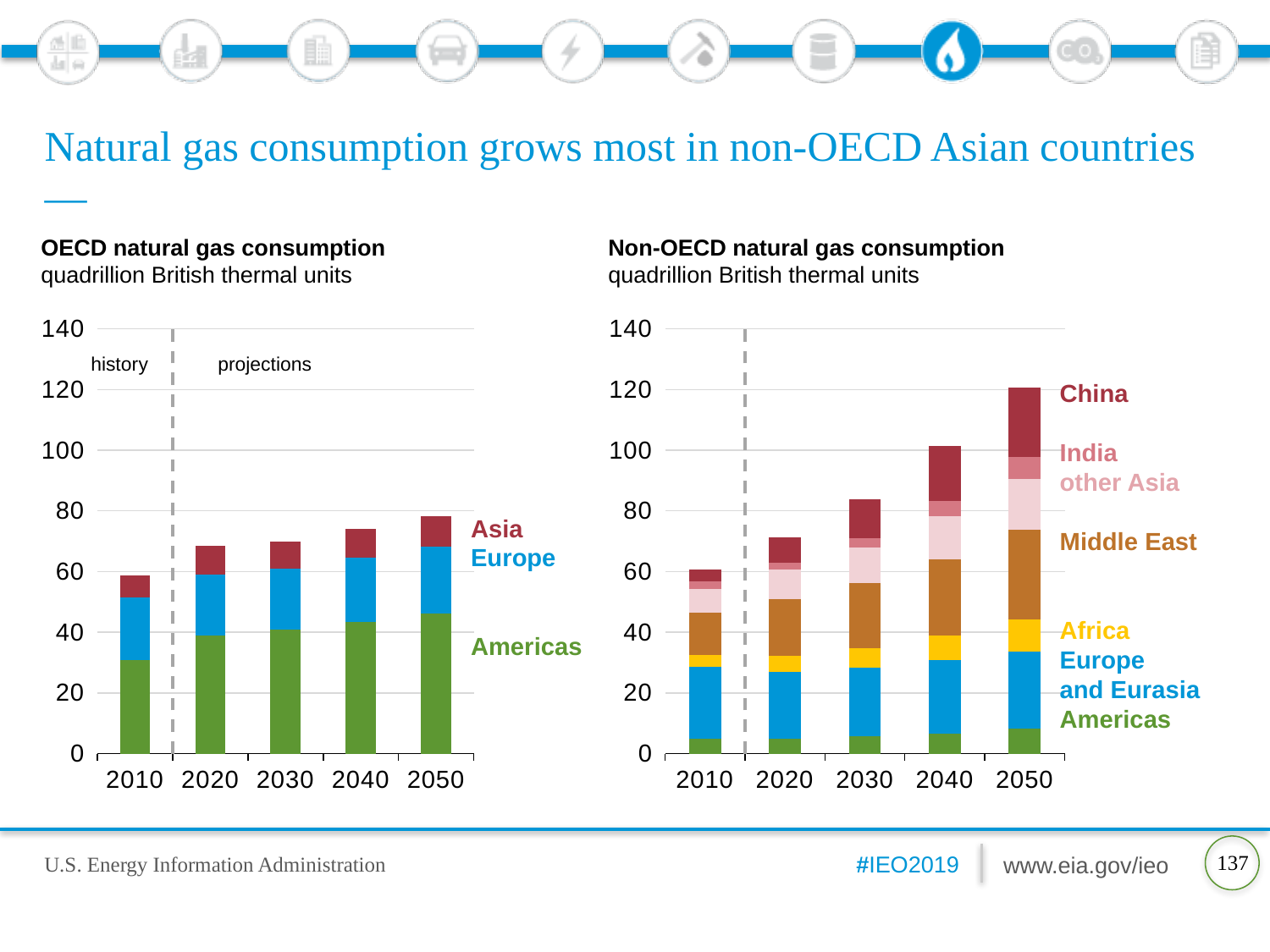
How many series are labelled on the OECD natural gas consumption chart? 3 How many years are shown on the x axis of the Non-OECD natural gas consumption chart? 5 In the Non-OECD natural gas consumption chart, which year has the highest total consumption? 2050 Which chart shows the larger total consumption in 2050, the OECD chart or the Non-OECD chart? Non-OECD In the OECD natural gas consumption chart, is the total for 2010 greater or less than 40? greater Do total values in the Non-OECD natural gas consumption chart rise or fall from 2010 to 2050? rise What kind of chart is the OECD natural gas consumption chart? stacked bar chart In the Non-OECD natural gas consumption chart, is the total for 2050 greater or less than 100? greater In the OECD natural gas consumption chart, which year has the lowest total consumption? 2010 What unit is given under the title of the OECD natural gas consumption chart? quadrillion British thermal units How many series are labelled on the Non-OECD natural gas consumption chart? 7